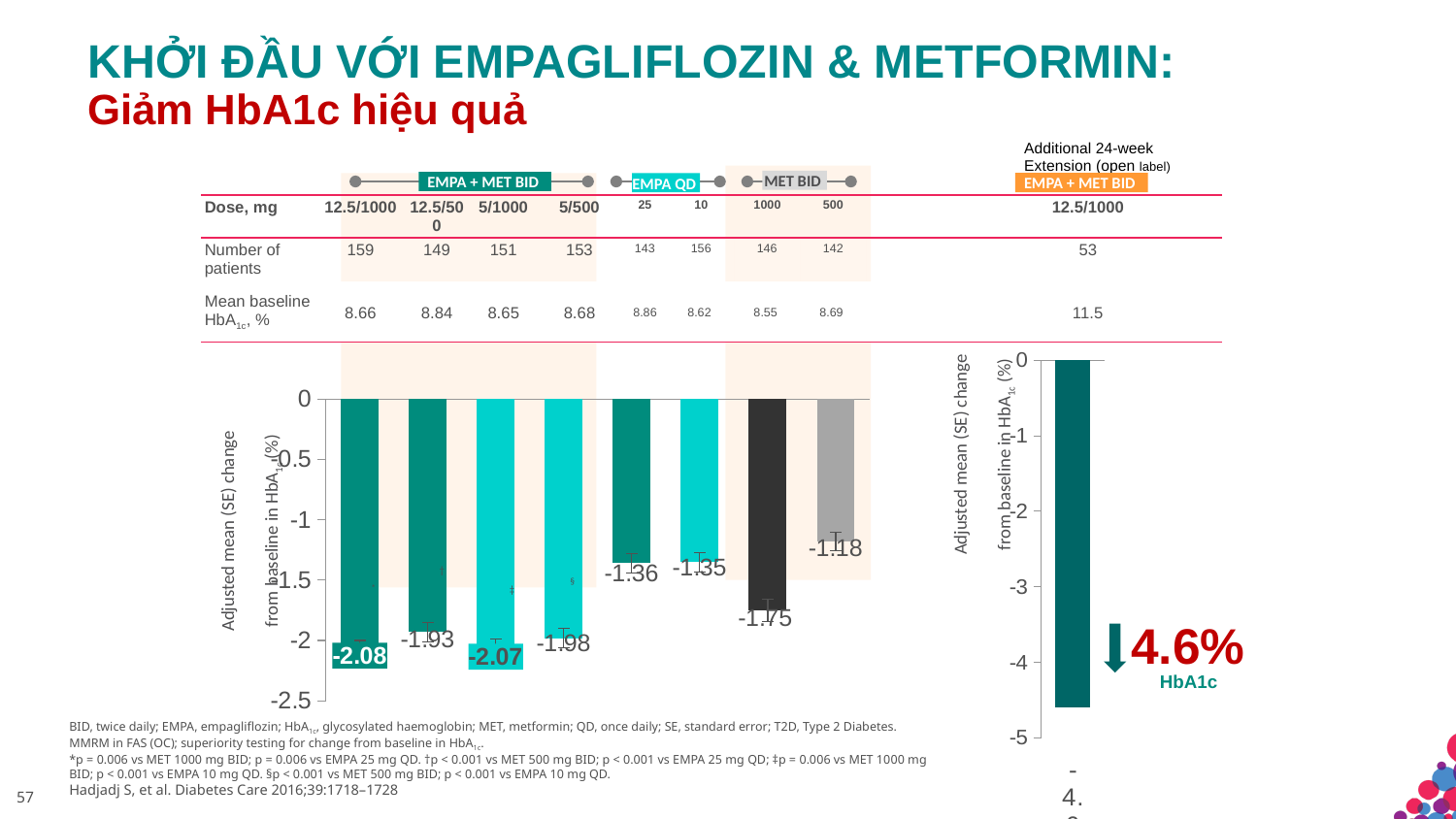
In the main bar chart, what is the adjusted mean change from baseline in HbA1c for MET 1000 mg BID? -1.75 What type of chart is used to show the change in HbA1c on this slide? Bar chart In the right-hand extension chart, is the plotted value greater or less than -4? less In the main bar chart, which dose group shows the smallest reduction in HbA1c? MET BID 500 mg In the main bar chart, which shows a larger reduction in HbA1c: EMPA 25 mg QD or MET 1000 mg BID? MET 1000 mg BID In the main bar chart, what is the adjusted mean change from baseline in HbA1c for EMPA 25 mg QD? -1.36 In the main bar chart, what is the adjusted mean change from baseline in HbA1c for EMPA + MET BID 12.5/1000 mg? -2.08 In the main bar chart, what is the difference between the HbA1c change for MET 1000 mg BID and MET 500 mg BID? 0.57 How many bars are plotted in the main bar chart? 8 How many treatment groups does the legend above the main bar chart list? 3 In the right-hand chart for the 24-week extension, what HbA1c reduction is highlighted in large text? 4.6% In the main bar chart, what is the adjusted mean change from baseline in HbA1c for EMPA + MET BID 5/500 mg? -1.98